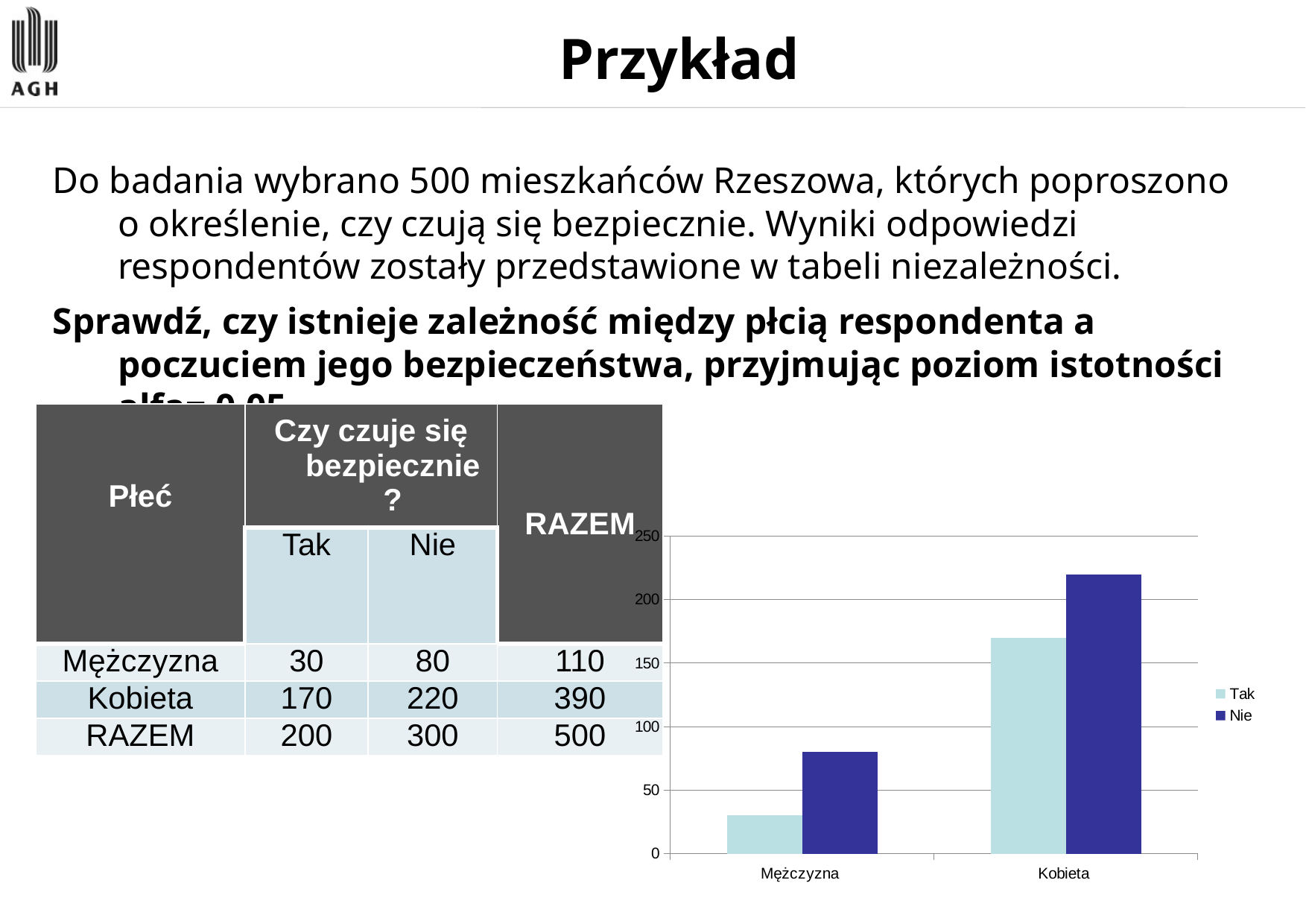
How many series does the chart legend list? 2 How many categories are shown on the x axis of the chart? 2 What kind of chart is shown on the slide? bar chart Which category has the shortest bar in the chart? Mężczyzna Is the Nie value for Mężczyzna greater or less than 100? less Is the Tak value for Mężczyzna greater or less than 50? less For Mężczyzna, which series has the larger bar, Tak or Nie? Nie Which series is shown in dark blue in the chart? Nie Which category has the tallest bar in the chart? Kobieta What are the two series named in the chart legend? Tak and Nie Is the Nie value for Kobieta greater or less than 200? greater